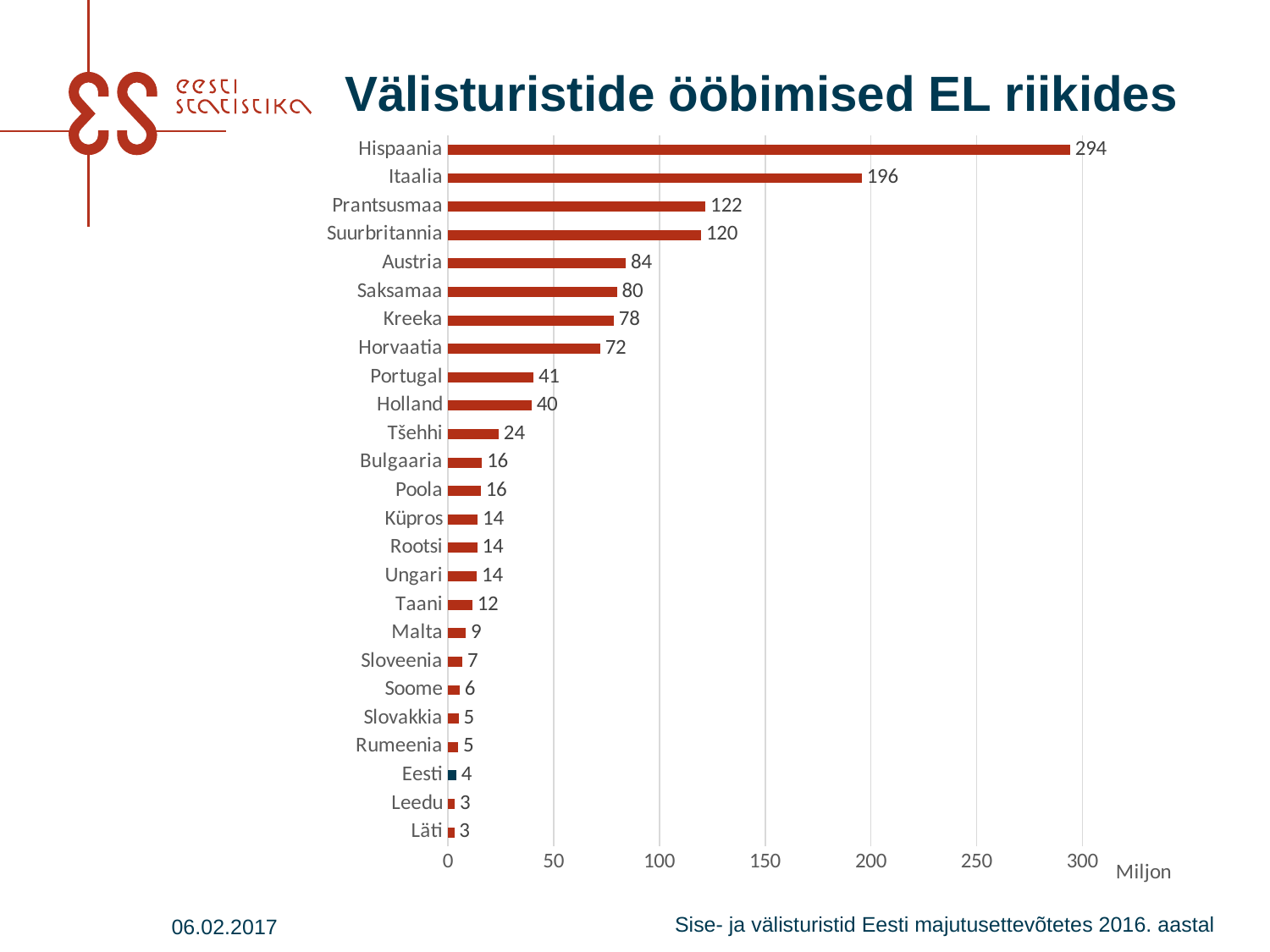
Which is larger, the value for Austria or the value for Kreeka? Austria What is the difference between the values for Hispaania and Itaalia? 98 What is the value for Hispaania? 294 How many countries are shown in the chart? 25 Is the value for Itaalia greater or less than 150? greater What is the difference between the values for Portugal and Holland? 1 What is the value for Saksamaa? 80 What is the value for Eesti? 4 What unit label is shown at the end of the horizontal axis? Miljon What is the title of the chart? Välisturistide ööbimised EL riikides What kind of chart is shown on the slide? bar chart Which country has the highest value? Hispaania